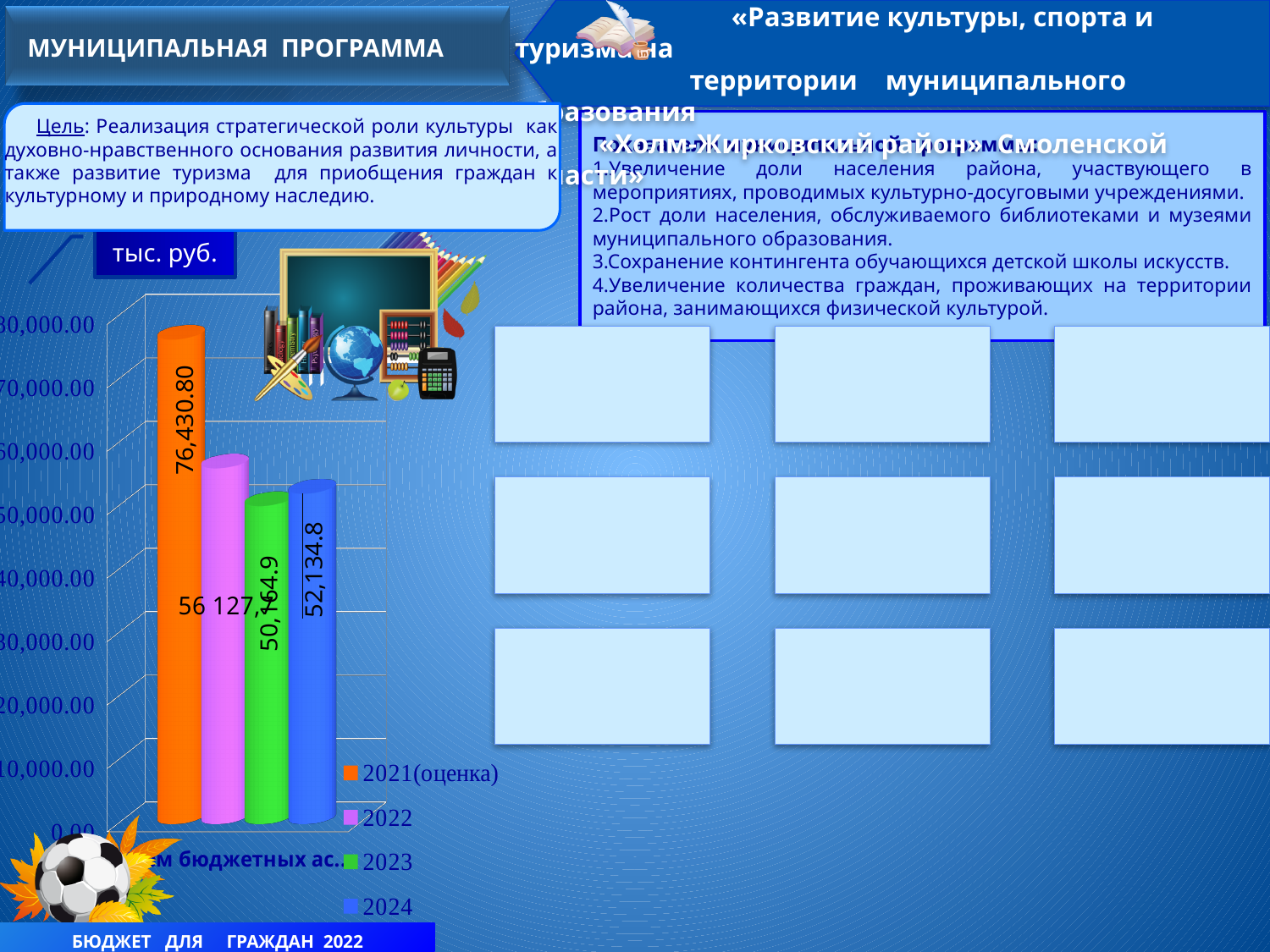
What kind of chart is shown on the slide? bar chart What unit is shown in the label above the bar chart? тыс. руб. Which year has the highest value in the bar chart? 2021(оценка) Do the values fall or rise from 2021(оценка) to 2023 in the bar chart? fall What is the value for 2023 in the bar chart? 50,164.9 What is the value for 2024 in the bar chart? 52,134.8 Which year has the lowest value in the bar chart? 2023 What is the difference between the values for 2024 and 2023 in the bar chart? 1,969.9 Which is larger in the bar chart, the value for 2023 or the value for 2024? 2024 Is the value for 2022 in the bar chart greater or less than 50,000.00? greater What is the value for 2021(оценка) in the bar chart? 76,430.80 How many series does the legend of the bar chart list? 4